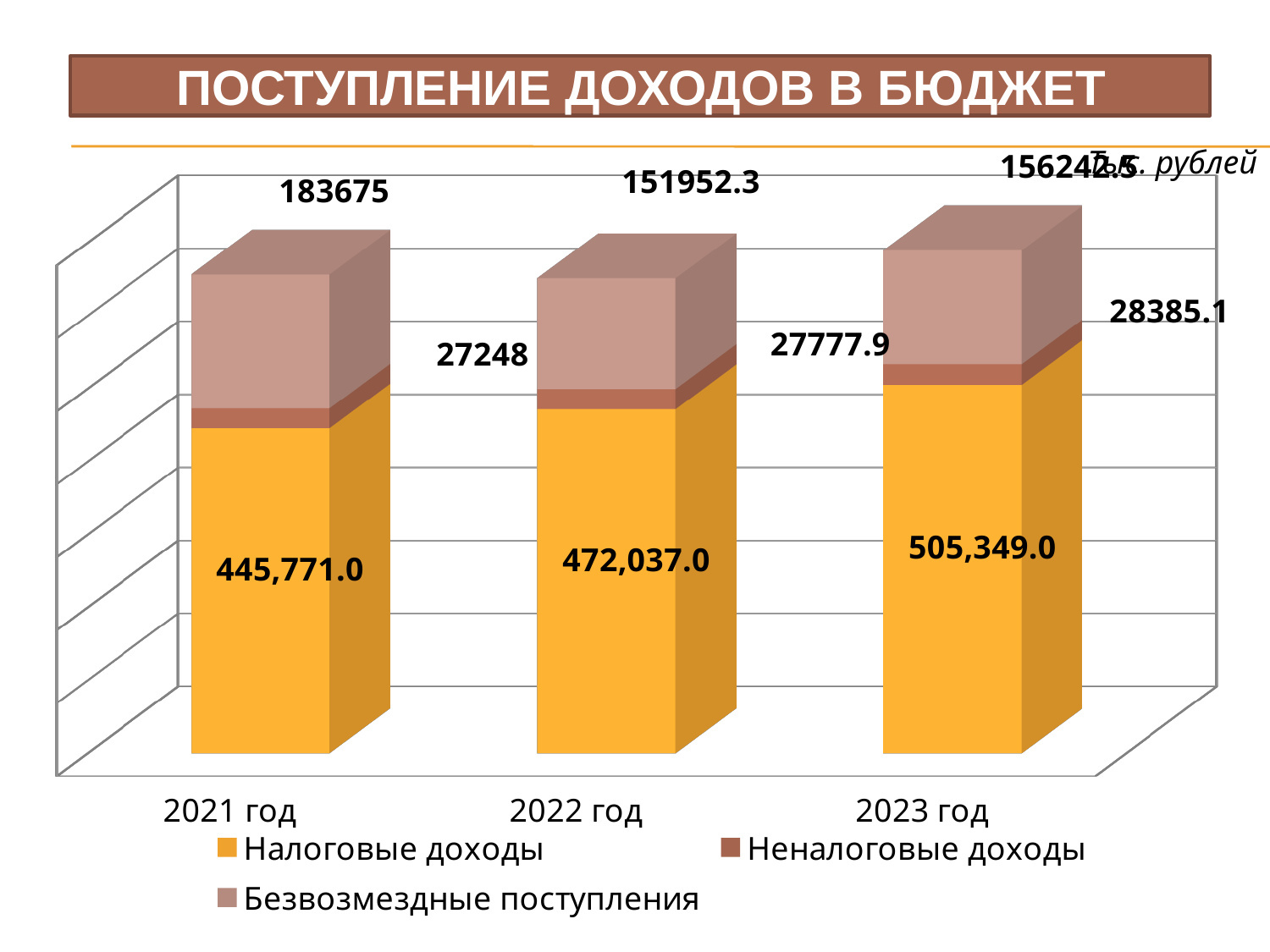
How many series does the legend list? 3 What is the value of Безвозмездные поступления for 2022 год? 151952.3 Do the values of Налоговые доходы rise or fall from 2021 год to 2023 год? Rise How many years (categories) are shown on the x axis? 3 What is the value of Налоговые доходы for 2023 год? 505,349.0 What is the value of Безвозмездные поступления for 2021 год? 183675 In which year is the value of Безвозмездные поступления the lowest? 2022 год What is the difference between Налоговые доходы in 2023 год and in 2021 год? 59,578.0 What is the value of Налоговые доходы for 2022 год? 472,037.0 What kind of chart is shown on the slide? Stacked bar chart In which year is the value of Налоговые доходы the highest? 2023 год What is the value of Налоговые доходы for 2021 год? 445,771.0